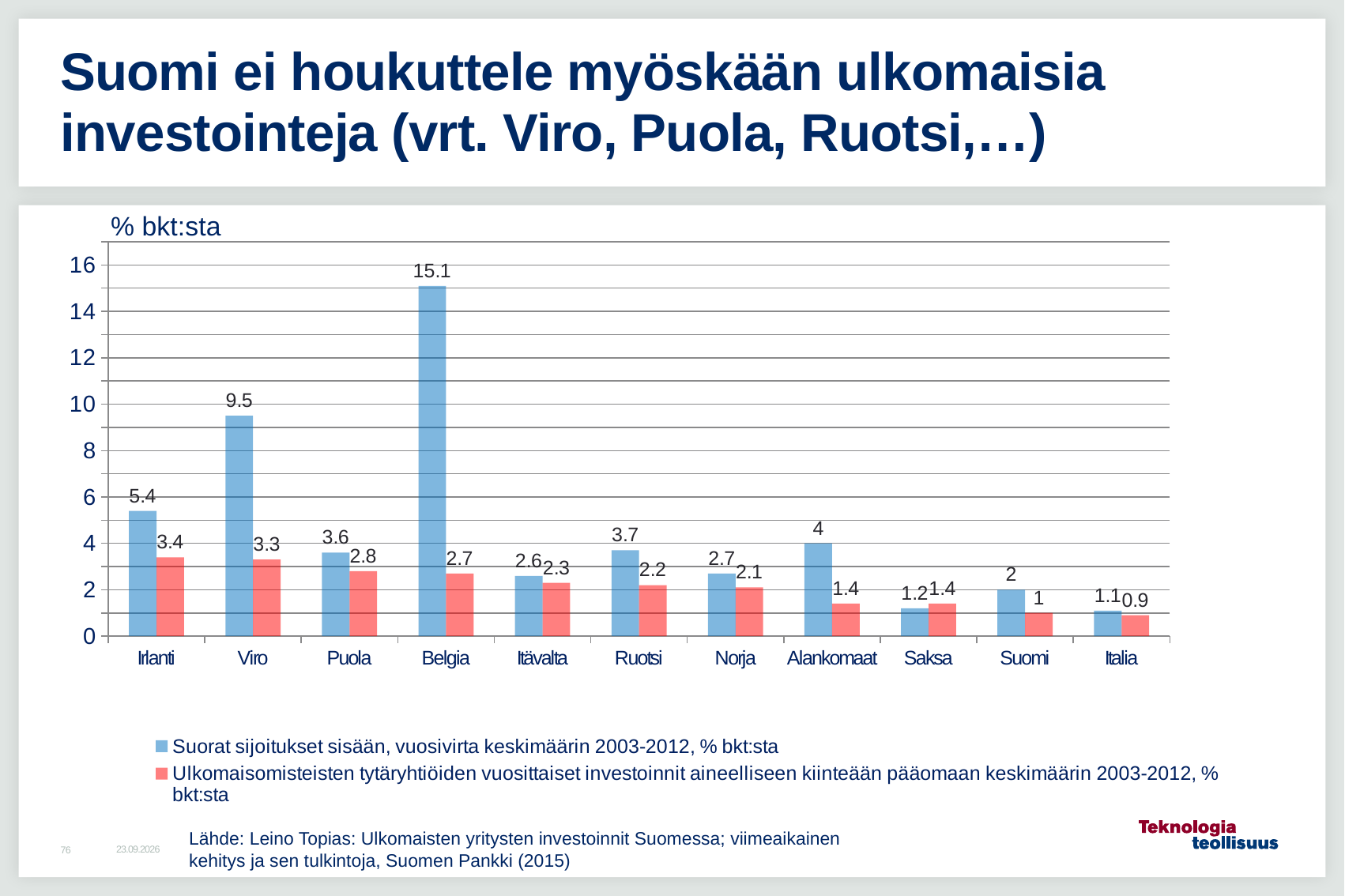
What unit label is shown above the y axis of the chart? % bkt:sta Is the blue series value for Alankomaat greater or less than 2? greater Which country has the lowest value in the red series (Ulkomaisomisteisten tytäryhtiöiden investoinnit)? Italia Which is larger: the blue series value for Ruotsi or for Puola? Ruotsi What is the value of the red series (Ulkomaisomisteisten tytäryhtiöiden investoinnit) for Suomi? 1 How many countries are shown on the x axis? 11 How many series does the legend list? 2 What kind of chart is shown on the slide? Bar chart What is the value of the blue series (Suorat sijoitukset sisään) for Viro? 9.5 What is the difference between the blue series values for Viro and Suomi? 7.5 Which country has the highest value in the blue series (Suorat sijoitukset sisään)? Belgia What is the value of the blue series (Suorat sijoitukset sisään) for Belgia? 15.1